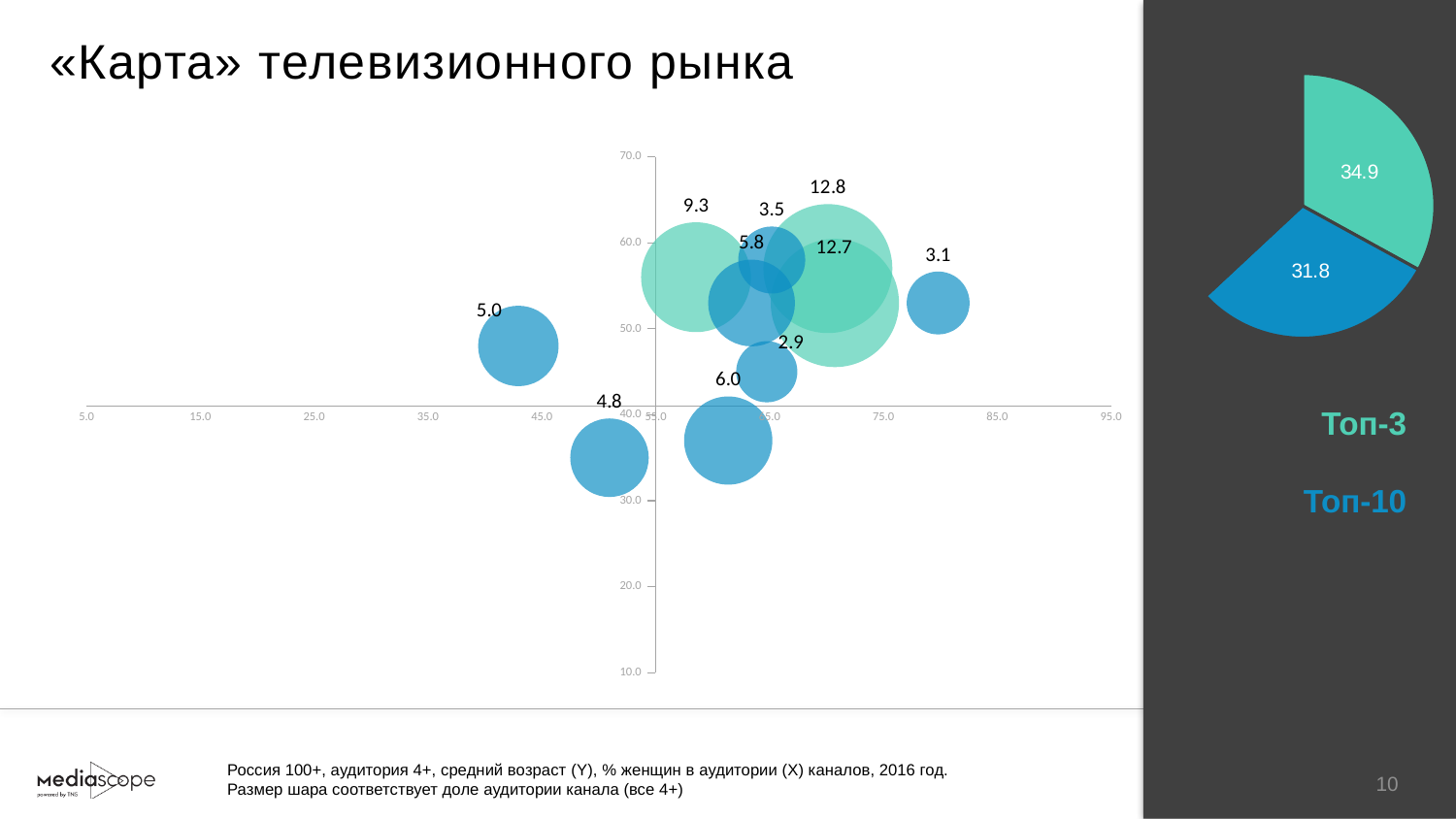
In the bubble chart on the left, what is the largest bubble value labelled? 12.8 In the pie chart on the right, which slice is larger, Топ-3 or Топ-10? Топ-3 In the bubble chart on the left, what is the smallest bubble value labelled? 2.9 In the bubble chart on the left, is the y-axis position of the bubble labelled 4.8 greater or less than 40.0? less In the pie chart on the right, what is the value of the Топ-3 slice? 34.9 What kind of chart is the large chart on the left of the slide? bubble chart In the bubble chart on the left, how many bubbles are plotted? 10 In the bubble chart on the left, is the x-axis position of the bubble labelled 3.1 greater or less than 75.0? greater In the pie chart on the right, what is the value of the Топ-10 slice? 31.8 What kind of chart is shown on the right side of the slide? pie chart In the bubble chart on the left, what is the highest value shown on the y-axis? 70.0 In the bubble chart on the left, is the y-axis position of the bubble labelled 12.8 greater or less than 50.0? greater